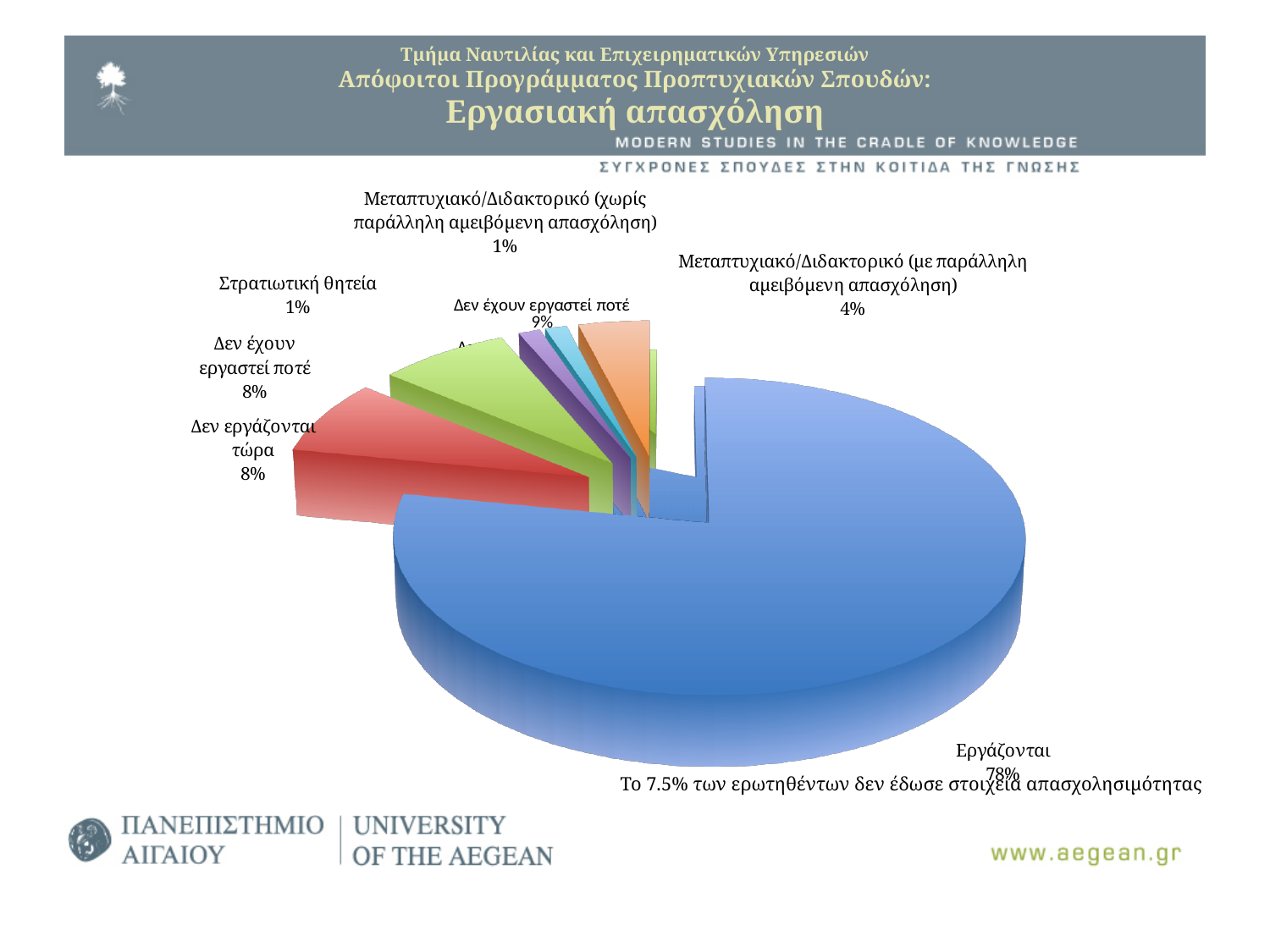
What is the difference in percentage points between "Εργάζονται" and "Δεν εργάζονται τώρα"? 70 percentage points What percentage is shown for "Στρατιωτική θητεία"? 1% Which category has the largest share of the pie? Εργάζονται What percentage is shown for "Δεν εργάζονται τώρα"? 8% According to the note below the chart, what percentage of respondents did not provide employment data? 7.5% What percentage is shown for "Μεταπτυχιακό/Διδακτορικό (με παράλληλη αμειβόμενη απασχόληση)"? 4% Which is larger: "Μεταπτυχιακό/Διδακτορικό (με παράλληλη αμειβόμενη απασχόληση)" or "Μεταπτυχιακό/Διδακτορικό (χωρίς παράλληλη αμειβόμενη απασχόληση)"? Μεταπτυχιακό/Διδακτορικό (με παράλληλη αμειβόμενη απασχόληση) What percentage is shown for "Μεταπτυχιακό/Διδακτορικό (χωρίς παράλληλη αμειβόμενη απασχόληση)"? 1% Which is larger: the share for "Εργάζονται" or for "Δεν εργάζονται τώρα"? Εργάζονται What kind of chart is shown on the slide? Pie chart What colour is the "Εργάζονται" slice of the pie? Blue What percentage of graduates are in the "Εργάζονται" category? 78%